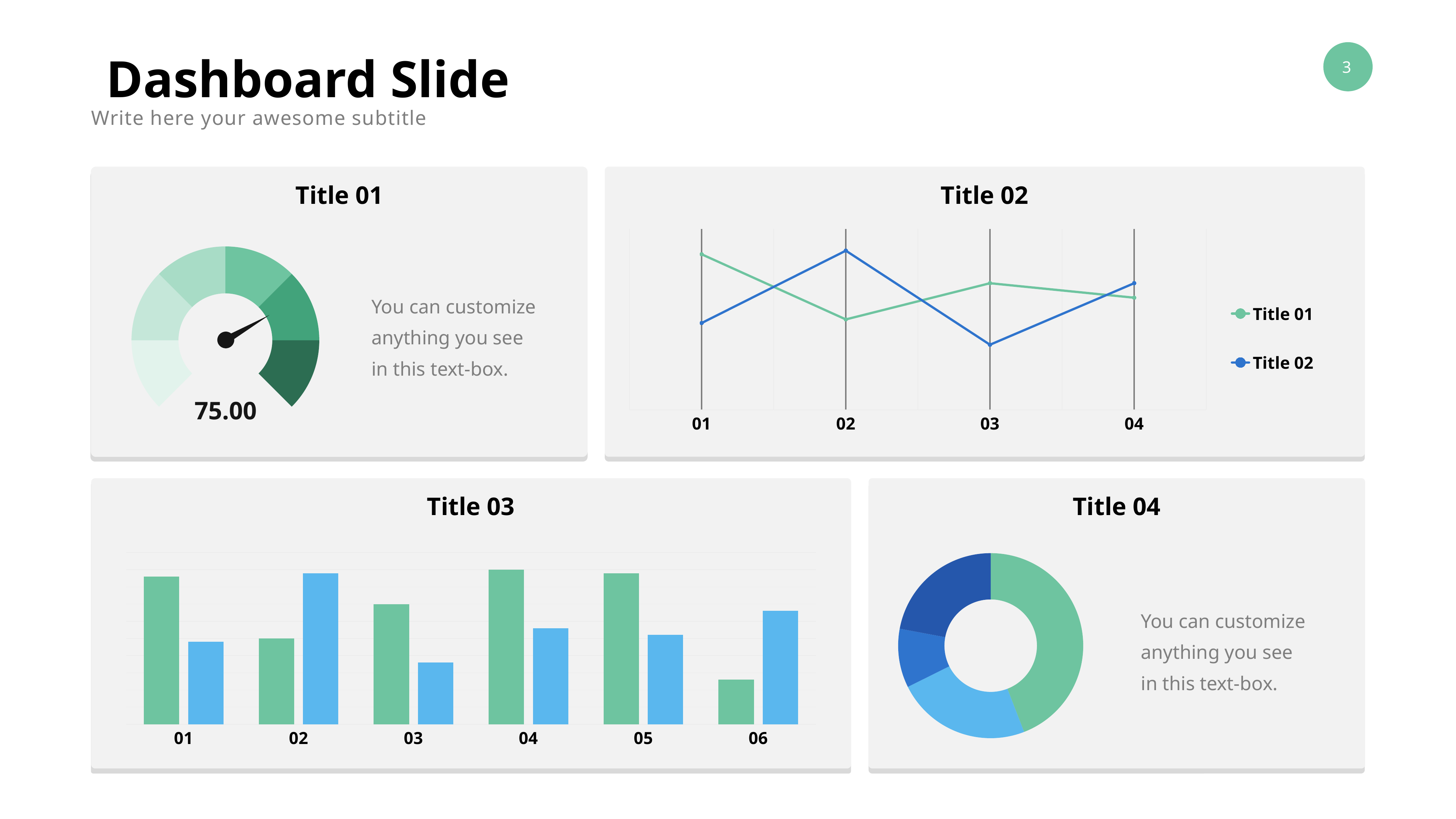
On the Title 02 chart, at which category does the Title 02 series reach its lowest value? 03 On the Title 02 chart, how many series does the legend list? 2 On the Title 04 chart, how many slices does the donut have? 4 What kind of chart is shown under Title 02? line chart On the Title 02 chart, at category 01, which series has the higher value, Title 01 or Title 02? Title 01 On the Title 03 chart, how many categories are shown on the x axis? 6 On the Title 02 chart, does the Title 01 series rise or fall from category 01 to category 02? fall What kind of chart is shown under Title 03? bar chart On the Title 02 chart, how many points are plotted along the x axis for each series? 4 On the Title 03 chart, at which category is the green bar the lowest? 06 On the Title 01 chart, what value does the gauge display? 75.00 On the Title 03 chart, at which category is the blue bar the highest? 02